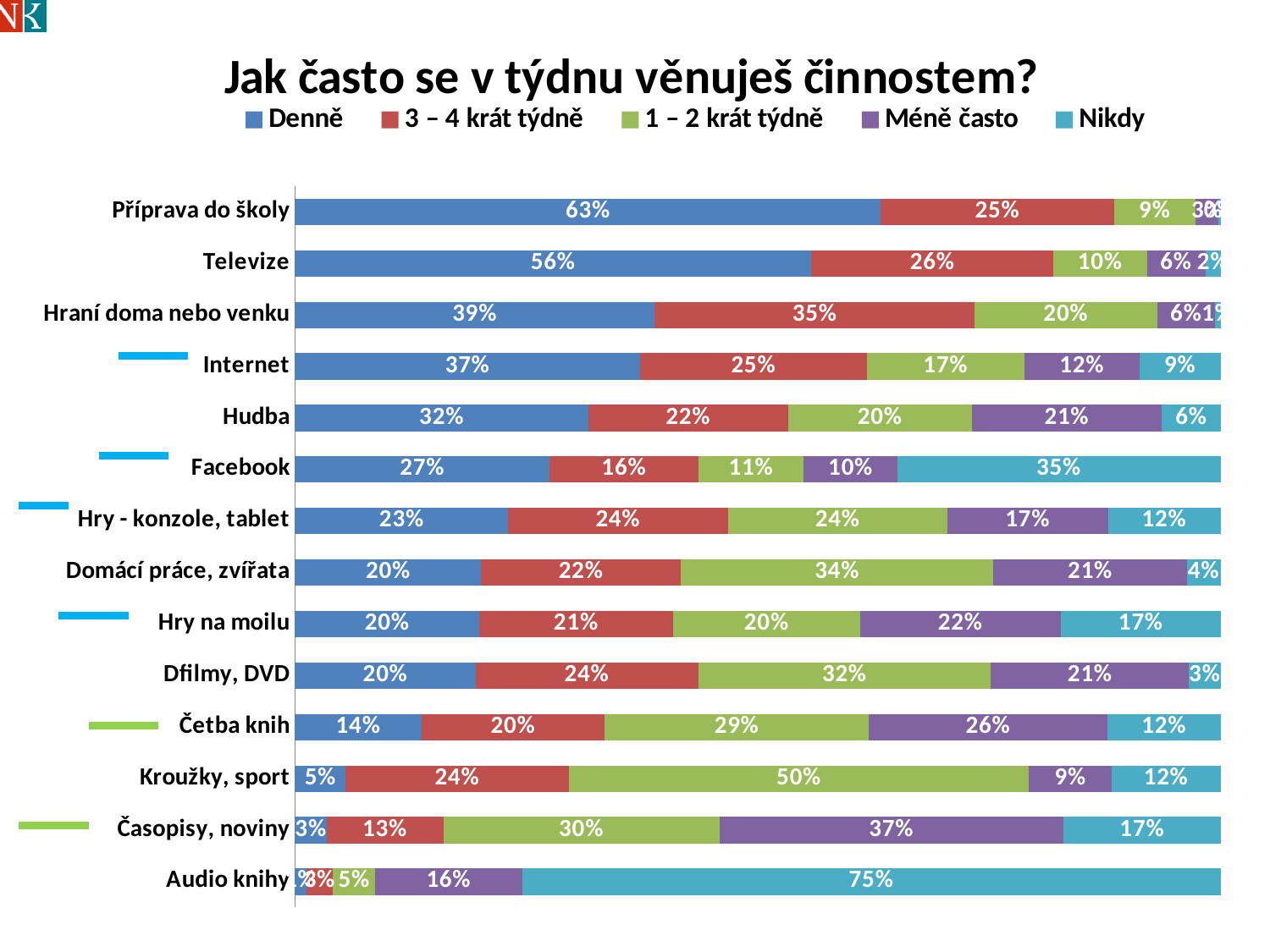
What is the '1 – 2 krát týdně' value for Kroužky, sport? 50% How many activities (categories) are shown in the chart? 14 What is the difference between the 'Nikdy' values for Facebook and Internet? 26 percentage points Which has a larger '1 – 2 krát týdně' value: Kroužky, sport or Domácí práce, zvířata? Kroužky, sport What is the 'Méně často' value for Časopisy, noviny? 37% What type of chart is shown on the slide? Stacked bar chart How many series does the legend list? 5 What is the 'Nikdy' value for Audio knihy? 75% Which activity has the highest 'Nikdy' share? Audio knihy What percentage of respondents do 'Příprava do školy' daily (Denně)? 63% What is the 'Nikdy' value for Facebook? 35% Which activity has the highest 'Denně' share? Příprava do školy